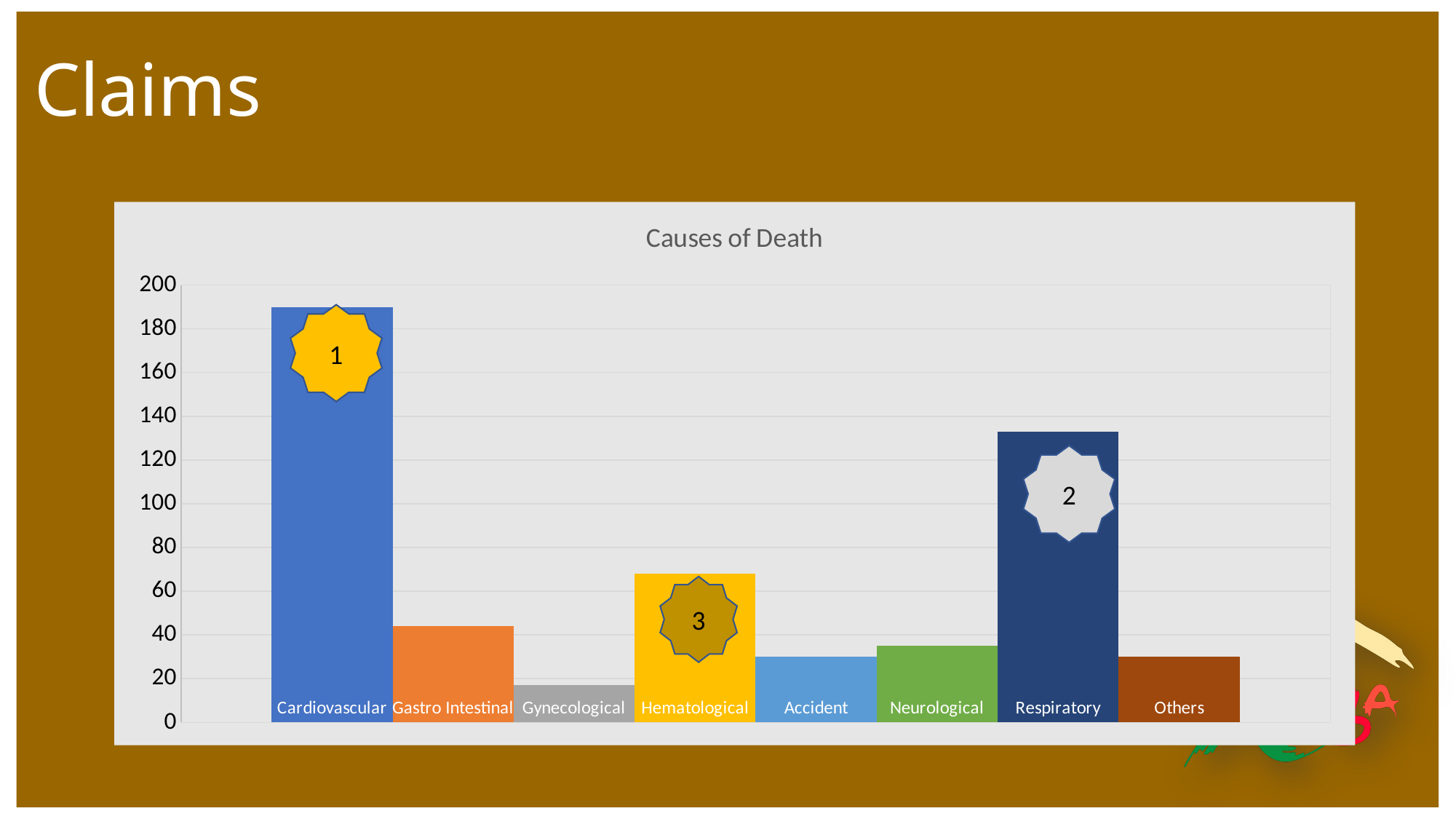
Is the value for Respiratory greater or less than 140? less What type of chart is shown on the slide? bar chart Which is larger, the value for Respiratory or the value for Hematological? Respiratory What is the title of the chart? Causes of Death Is the value for Cardiovascular greater or less than 180? greater How many categories are shown on the x axis of the chart? 8 Is the value for Gynecological greater or less than 20? less Which cause of death has the highest value? Cardiovascular What number is shown in the badge on the Respiratory bar? 2 Which cause of death has the lowest value? Gynecological